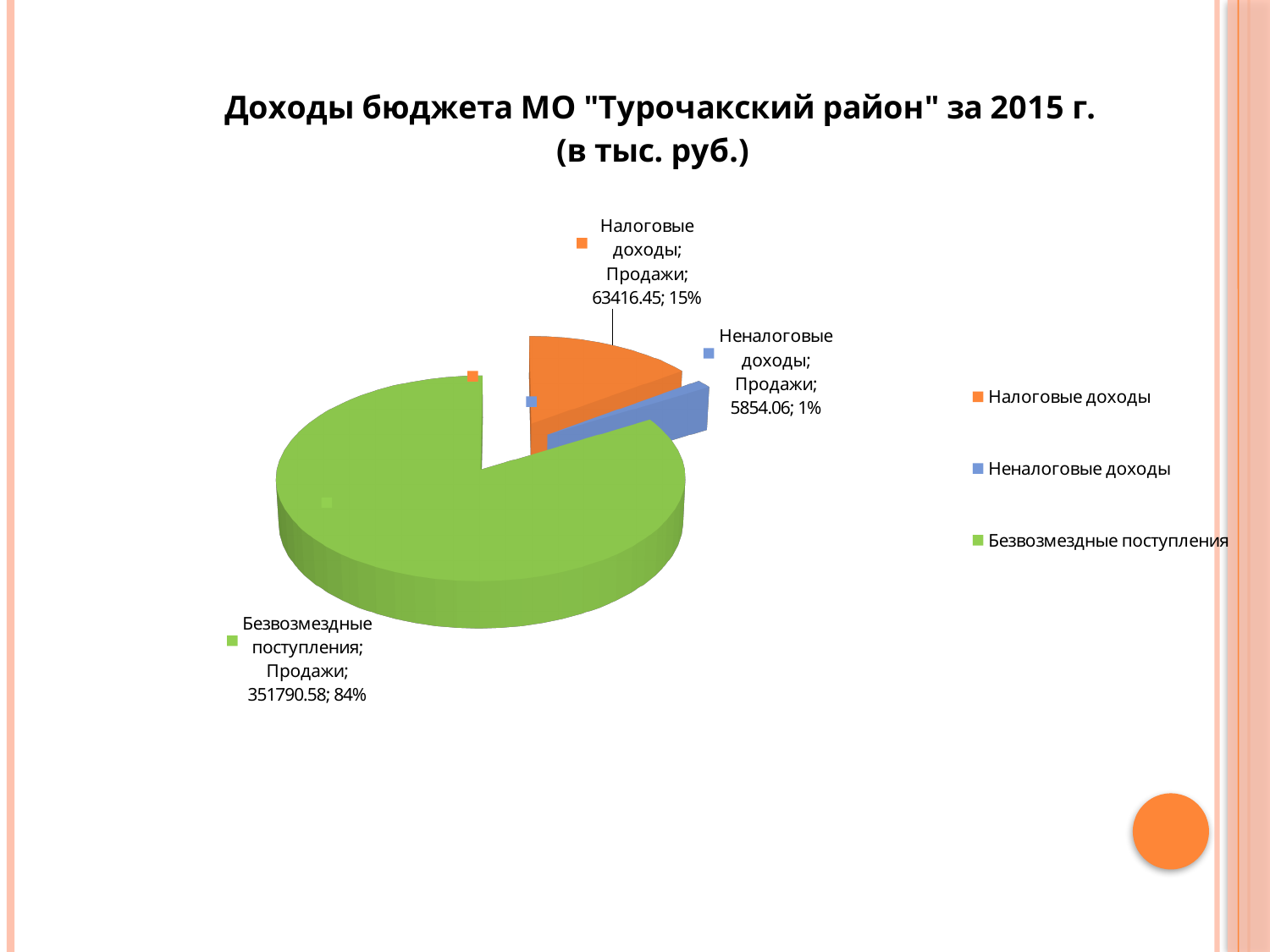
What is the title of the chart? Доходы бюджета МО "Турочакский район" за 2015 г. (в тыс. руб.) Which category has the largest value? Безвозмездные поступления Which category has the smallest value? Неналоговые доходы What share of the pie does Неналоговые доходы represent? 1% What is the value for Налоговые доходы? 63416.45 What share of the pie does Налоговые доходы represent? 15% What is the value for Безвозмездные поступления? 351790.58 How many categories does the pie chart have? 3 What is the value for Неналоговые доходы? 5854.06 What is the difference between the values for Безвозмездные поступления and Налоговые доходы? 288374.13 What share of the pie does Безвозмездные поступления represent? 84% What kind of chart is shown on the slide? Pie chart